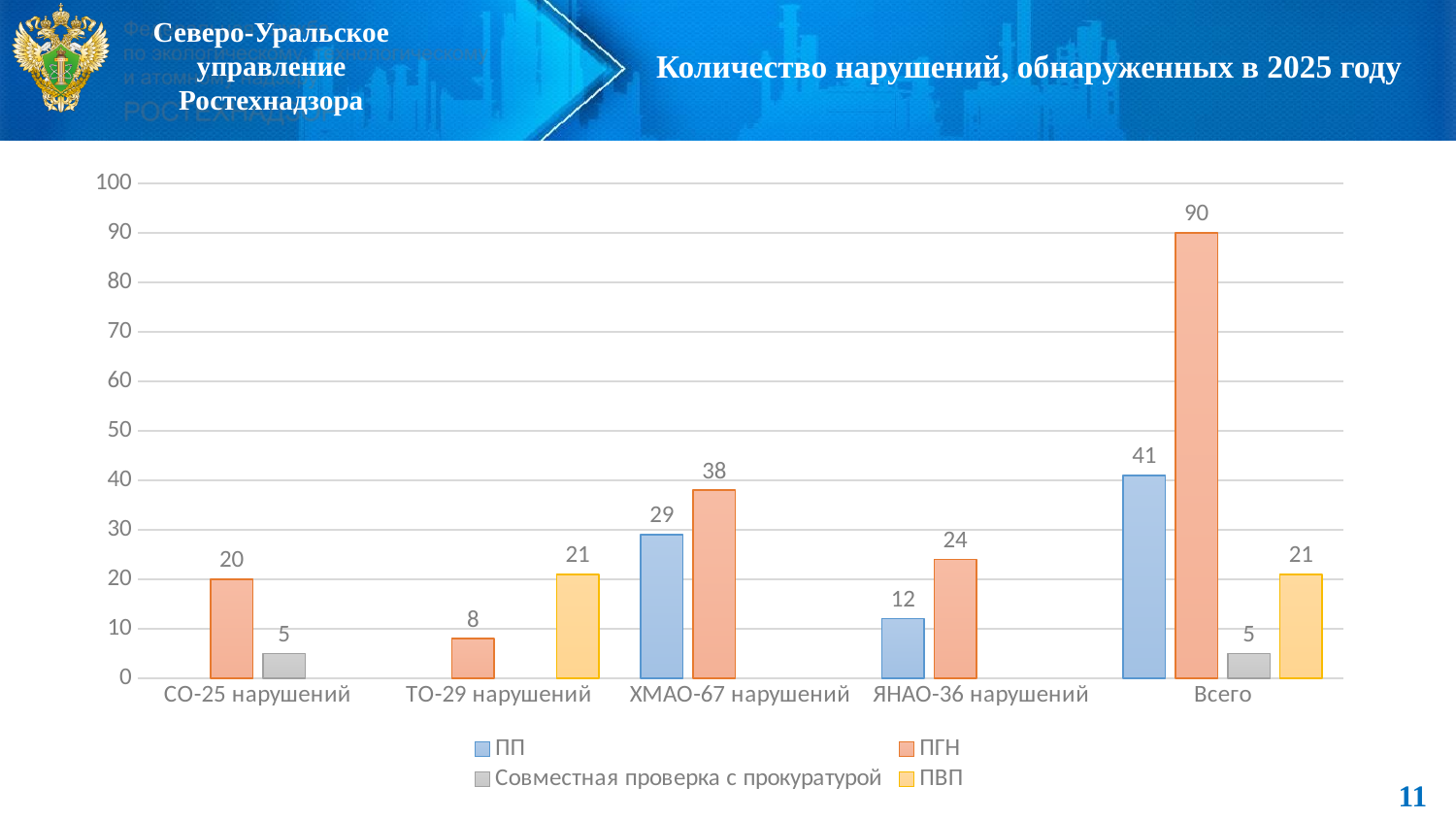
What is the value of ПВП for ТО-29 нарушений? 21 How many categories are shown on the x axis? 5 What type of chart is shown on the slide? Bar chart What is the difference between the ПГН and ПП values for Всего? 49 Which is larger for ХМАО-67 нарушений: ПП or ПГН? ПГН Is the ПГН value for Всего greater or less than 80? greater What is the value of ПП for ЯНАО-36 нарушений? 12 Which category has the highest ПГН value? Всего What is the value of Совместная проверка с прокуратурой for СО-25 нарушений? 5 How many series does the legend list? 4 Which category has the lowest ПГН value? ТО-29 нарушений What is the value of ПГН for ХМАО-67 нарушений? 38